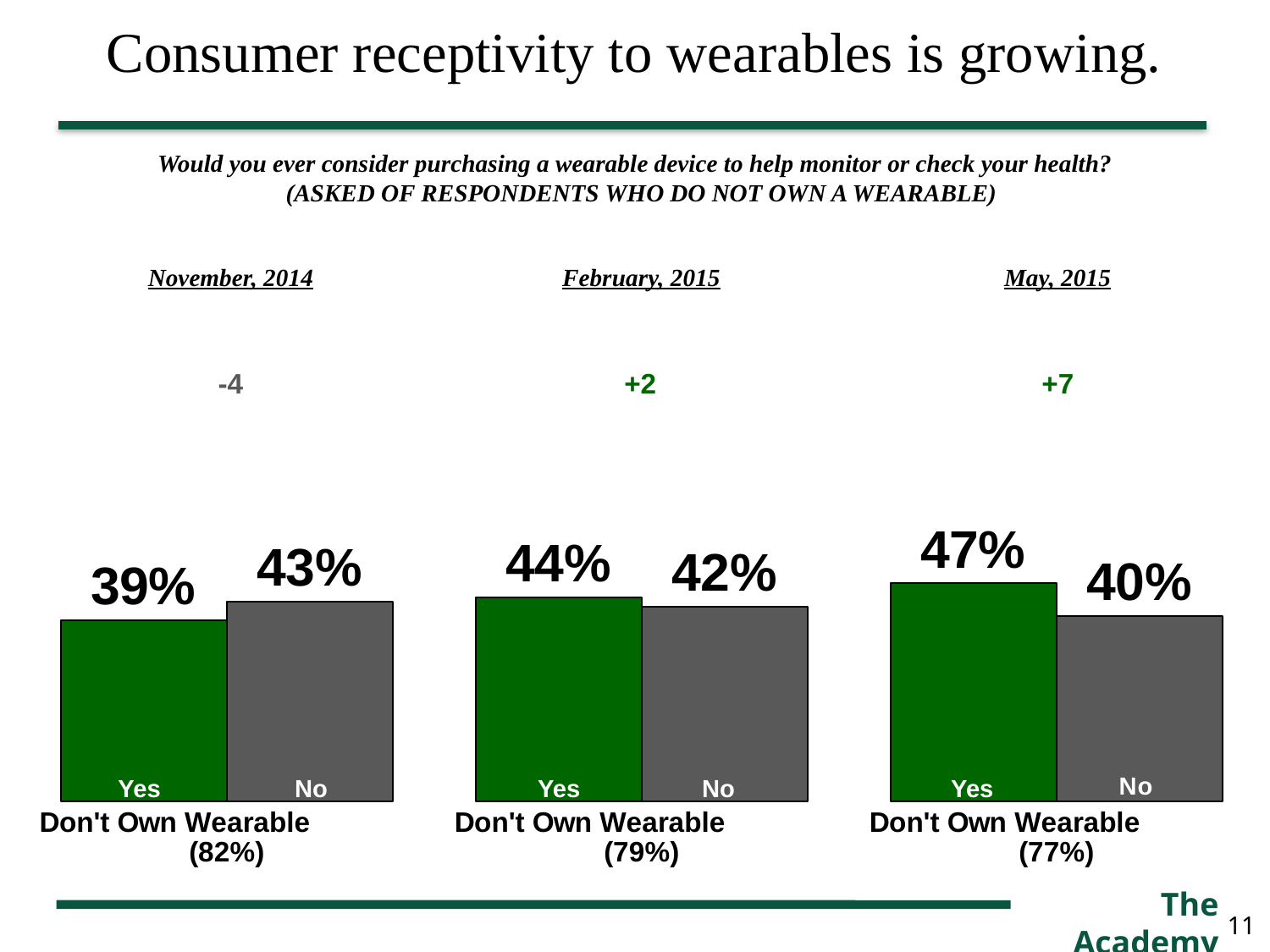
In the May, 2015 chart, what is the difference between the Yes and No percentages? 7 In the November, 2014 chart, what is the difference between the No and Yes percentages? 4 How many bars are shown in the May, 2015 chart? 2 In the November, 2014 chart, what percentage of respondents answered Yes? 39% What colour are the Yes bars in the charts? Green In the February, 2015 chart, which bar is higher, Yes or No? Yes What type of chart is used on this slide? Bar chart In the February, 2015 chart, what percentage of respondents answered No? 42% What percentage of respondents did not own a wearable in the May, 2015 survey, as shown under the chart? 77% In the May, 2015 chart, what percentage of respondents answered Yes? 47% Across the three charts from November, 2014 to May, 2015, does the Yes percentage rise or fall? Rise In the November, 2014 chart, which is larger, Yes or No? No